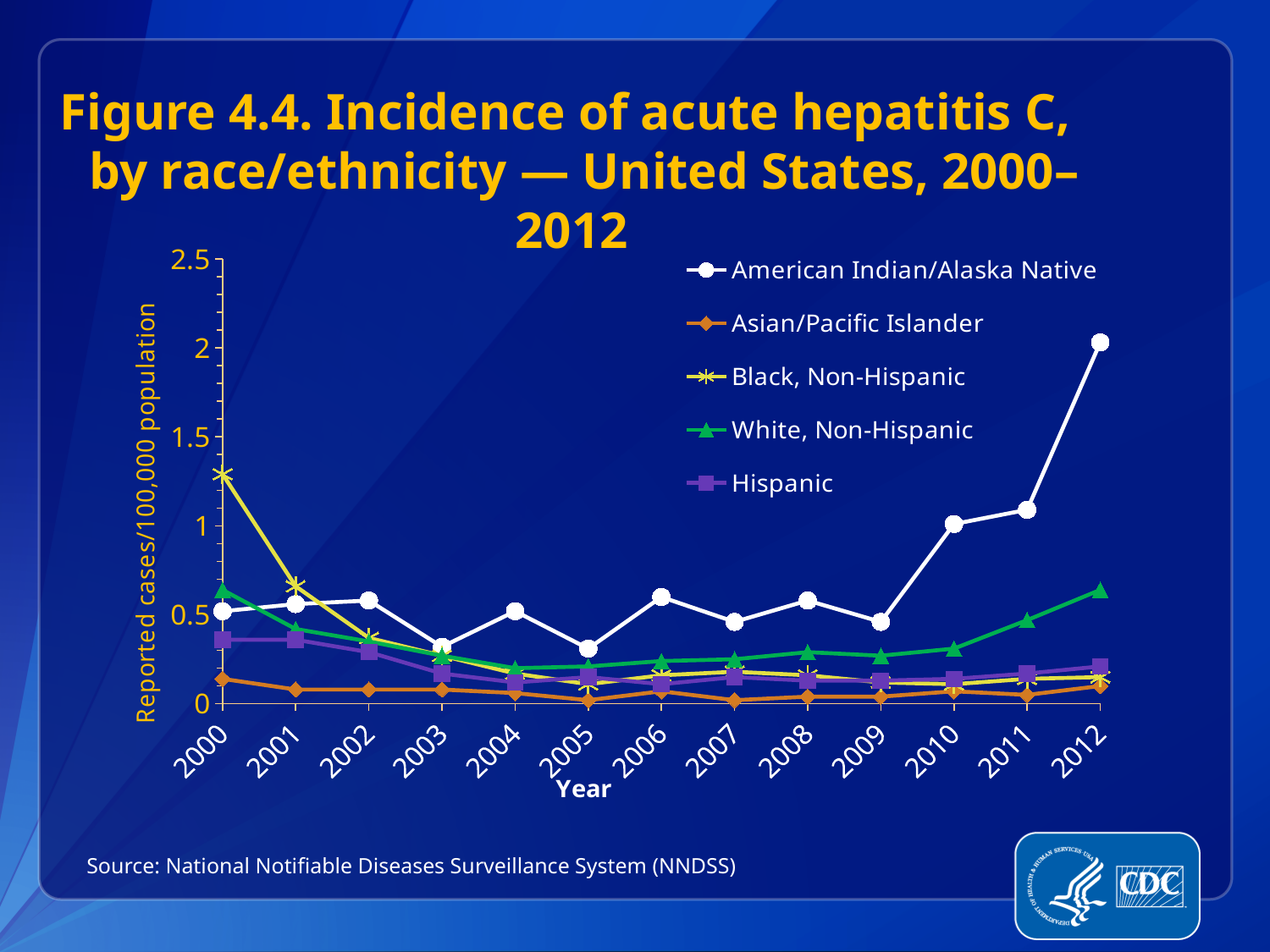
Which race/ethnicity group has the highest incidence in 2012? American Indian/Alaska Native Is the value for White, Non-Hispanic in 2012 greater or less than 1? less Which race/ethnicity group has the highest incidence in 2000? Black, Non-Hispanic What kind of chart is shown on the slide? line chart What is the label on the y axis? Reported cases/100,000 population Does the American Indian/Alaska Native line rise or fall from 2009 to 2012? rise How many series does the legend list? 5 Which race/ethnicity group has the lowest incidence in 2005? Asian/Pacific Islander Is the value for Black, Non-Hispanic in 2000 greater or less than 1? greater In 2012, which is larger: the value for American Indian/Alaska Native or for White, Non-Hispanic? American Indian/Alaska Native How many years are plotted along the x axis? 13 Is the value for American Indian/Alaska Native in 2012 greater or less than 1.5? greater